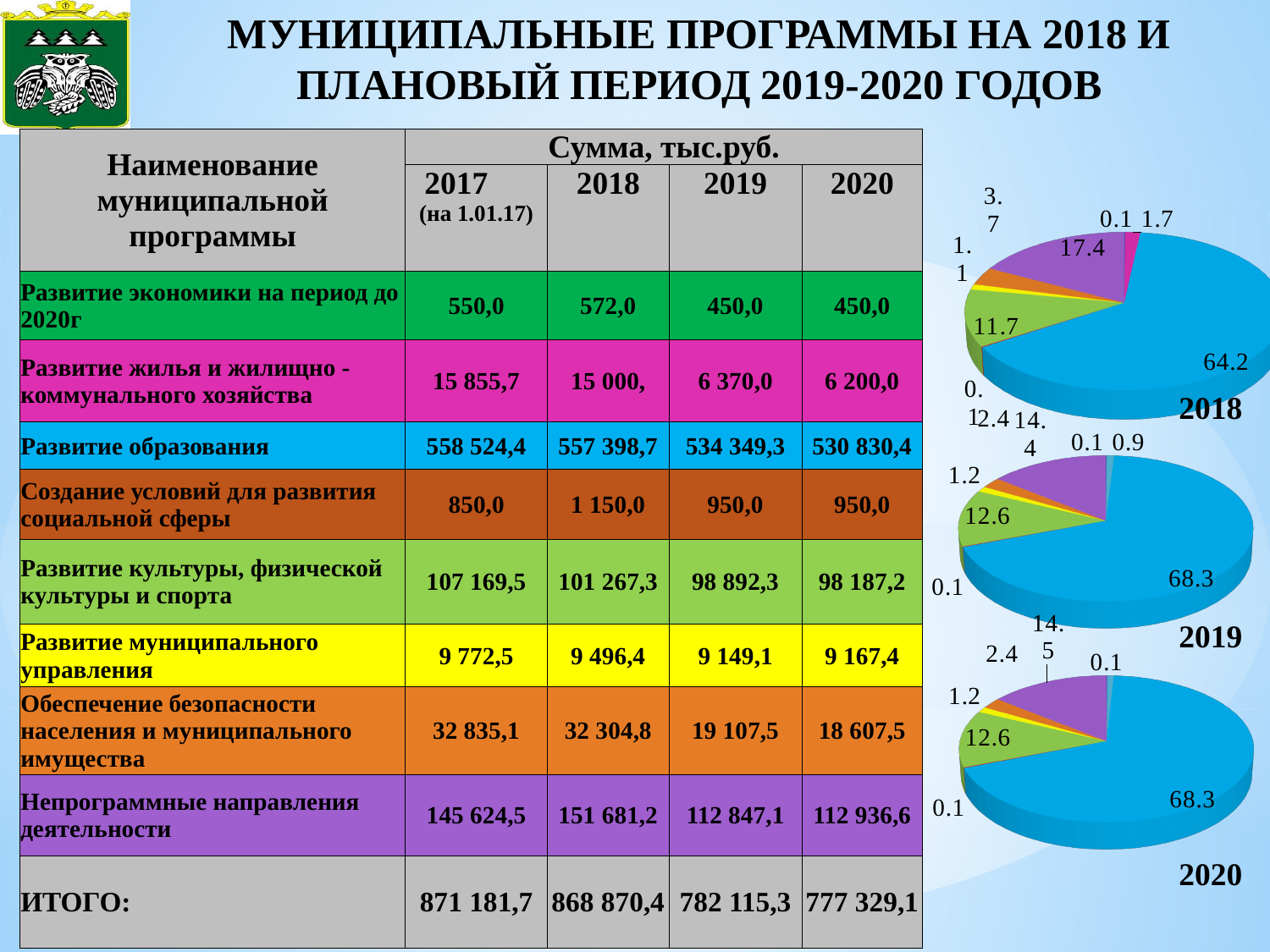
In the 2018 pie chart, what is the value of the green slice? 11.7 Which year labels are shown next to the three pie charts? 2018, 2019, 2020 In the 2018 pie chart, what is the value of the largest slice? 64.2 In the 2018 pie chart, which is larger: the purple slice or the green slice? The purple slice In the 2018 pie chart, what is the value of the purple slice? 17.4 In the 2019 pie chart, what is the value of the largest slice? 68.3 In the 2019 pie chart, what is the value of the green slice? 12.6 How many pie charts are shown on the slide? 3 What is the difference between the largest slice in the 2019 pie chart and the largest slice in the 2018 pie chart? 4.1 In the 2020 pie chart, what is the value of the largest slice? 68.3 What kind of chart is used for the 2018, 2019 and 2020 charts on the right of the slide? Pie chart In the 2020 pie chart, what is the value of the orange slice? 2.4